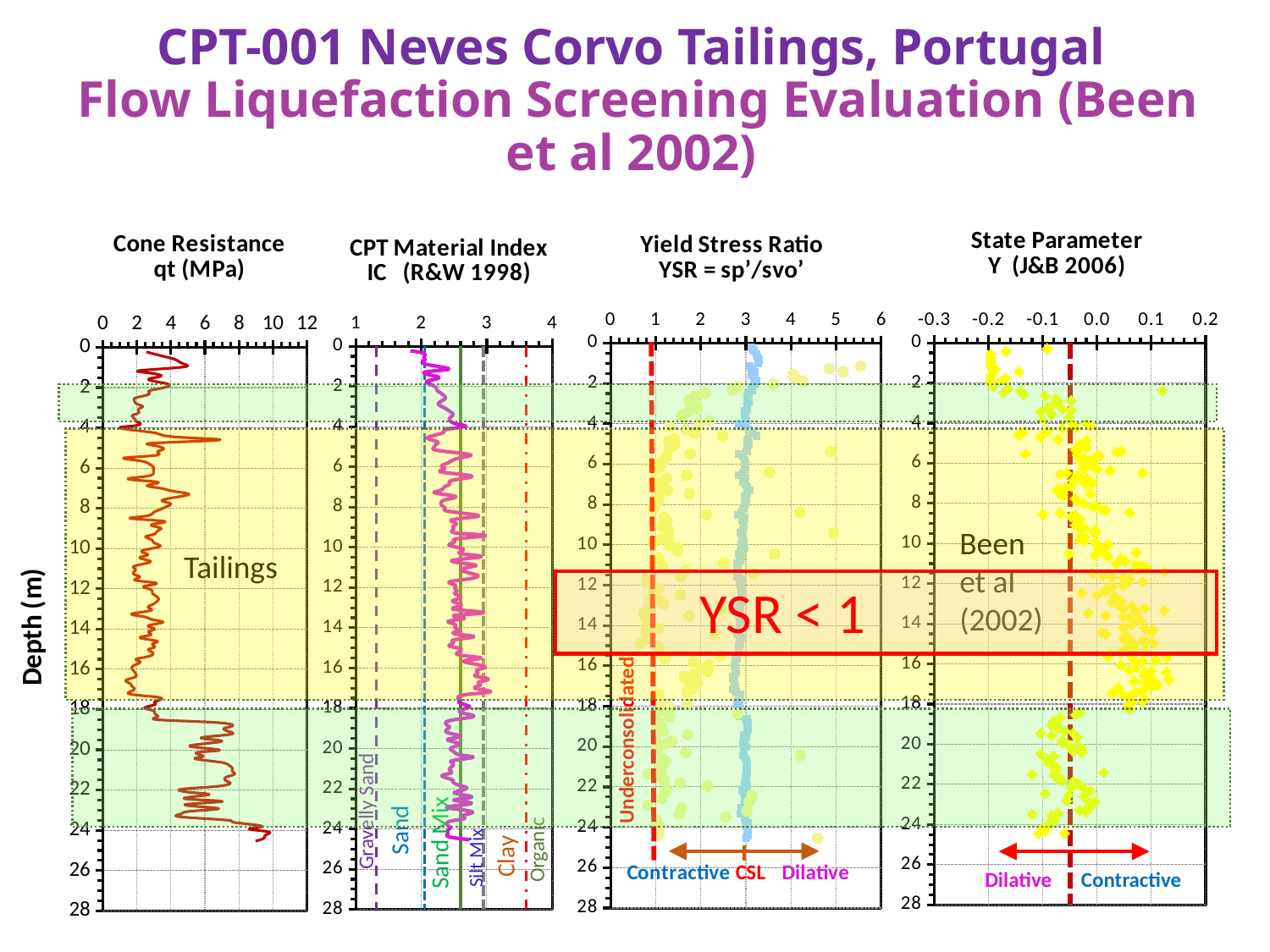
What is the maximum value on the Yield Stress Ratio axis? 6 What is the maximum depth shown on the Depth (m) axis? 28 In the Cone Resistance panel, is the value at 10 m depth greater or less than 4 MPa? less How many chart panels are shown on the slide? 4 What text is written inside the red box spanning the Yield Stress Ratio panel? YSR < 1 What is the minimum value on the State Parameter axis? -0.3 In the Yield Stress Ratio panel, at what YSR value is the vertical dashed red line drawn? 1 What label appears inside the yellow band of the Cone Resistance panel? Tailings In the Cone Resistance panel, is the value at 24 m depth greater or less than 6 MPa? greater What kind of chart is the Cone Resistance panel? line chart In the CPT Material Index panel, is the IC value at 10 m depth greater or less than 2? greater What is the maximum value on the Cone Resistance qt (MPa) axis? 12